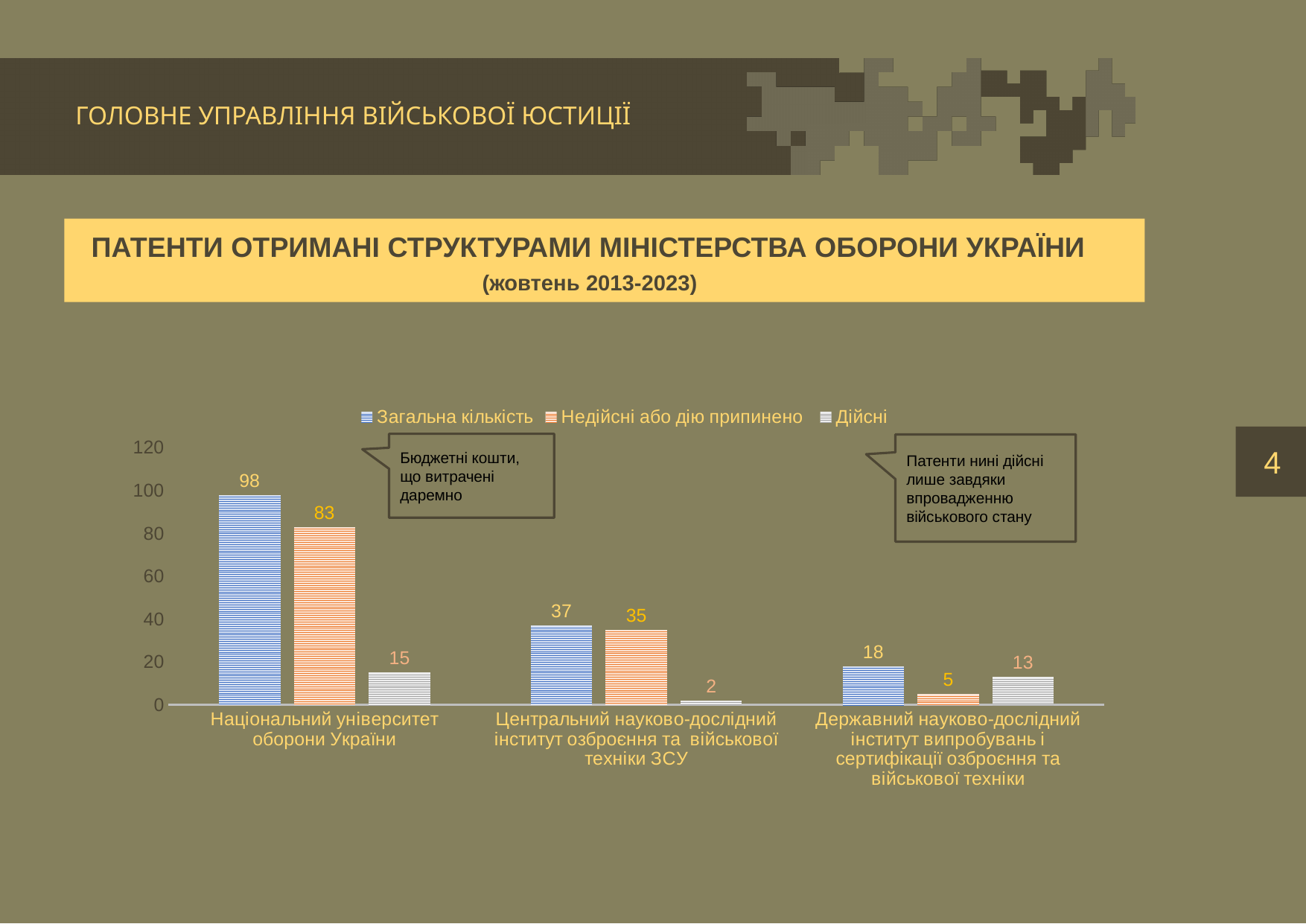
What is the value of 'Дійсні' for Державний науково-дослідний інститут випробувань і сертифікації озброєння та військової техніки? 13 How many series does the legend list? 3 What is the difference between 'Загальна кількість' and 'Недійсні або дію припинено' for Національний університет оборони України? 15 Which category has the lowest value for 'Дійсні'? Центральний науково-дослідний інститут озброєння та військової техніки ЗСУ Which is larger for Державний науково-дослідний інститут випробувань і сертифікації озброєння та військової техніки: 'Недійсні або дію припинено' or 'Дійсні'? Дійсні What is the title of the chart? ПАТЕНТИ ОТРИМАНІ СТРУКТУРАМИ МІНІСТЕРСТВА ОБОРОНИ УКРАЇНИ (жовтень 2013-2023) Which category has the highest value for 'Загальна кількість'? Національний університет оборони України How many categories are shown on the x axis? 3 What is the value of 'Недійсні або дію припинено' for Центральний науково-дослідний інститут озброєння та військової техніки ЗСУ? 35 What is the value of 'Загальна кількість' for Національний університет оборони України? 98 What kind of chart is shown on the slide? bar chart Does the value of 'Загальна кількість' rise or fall from left to right across the categories? fall